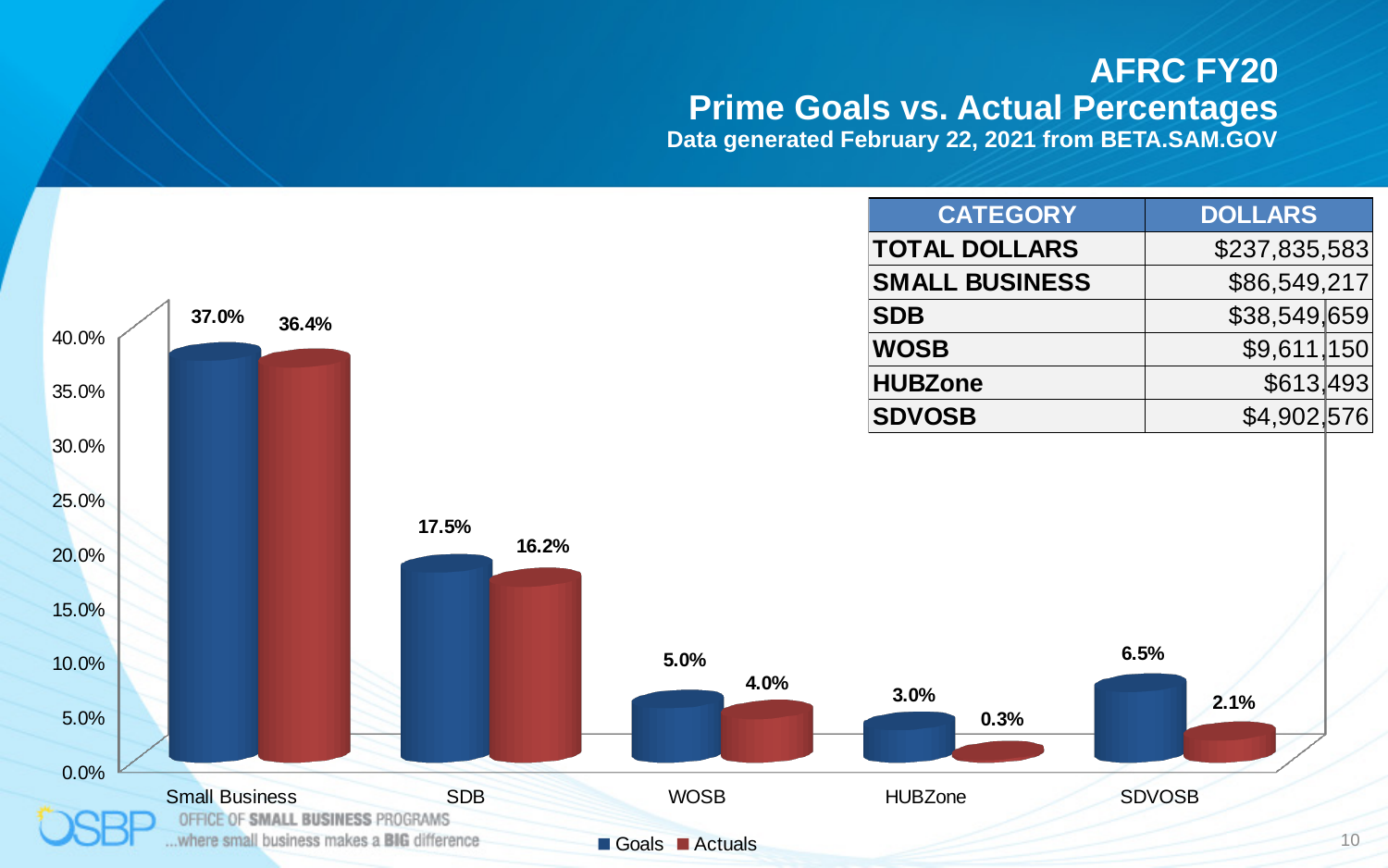
What is the Actuals value for HUBZone? 0.3% What kind of chart is shown on the slide? Bar chart What is the difference between the Goals and Actuals values for WOSB? 1.0% Which category has the highest Actuals value? Small Business Which category has the lowest Actuals value? HUBZone Which is larger for SDB, the Goals value or the Actuals value? Goals How many series does the chart legend list? 2 What is the Goals value for Small Business? 37.0% What is the Goals value for SDVOSB? 6.5% What is the Actuals value for SDB? 16.2% What is the difference between the Goals and Actuals values for SDVOSB? 4.4% How many categories are shown on the x axis of the chart? 5